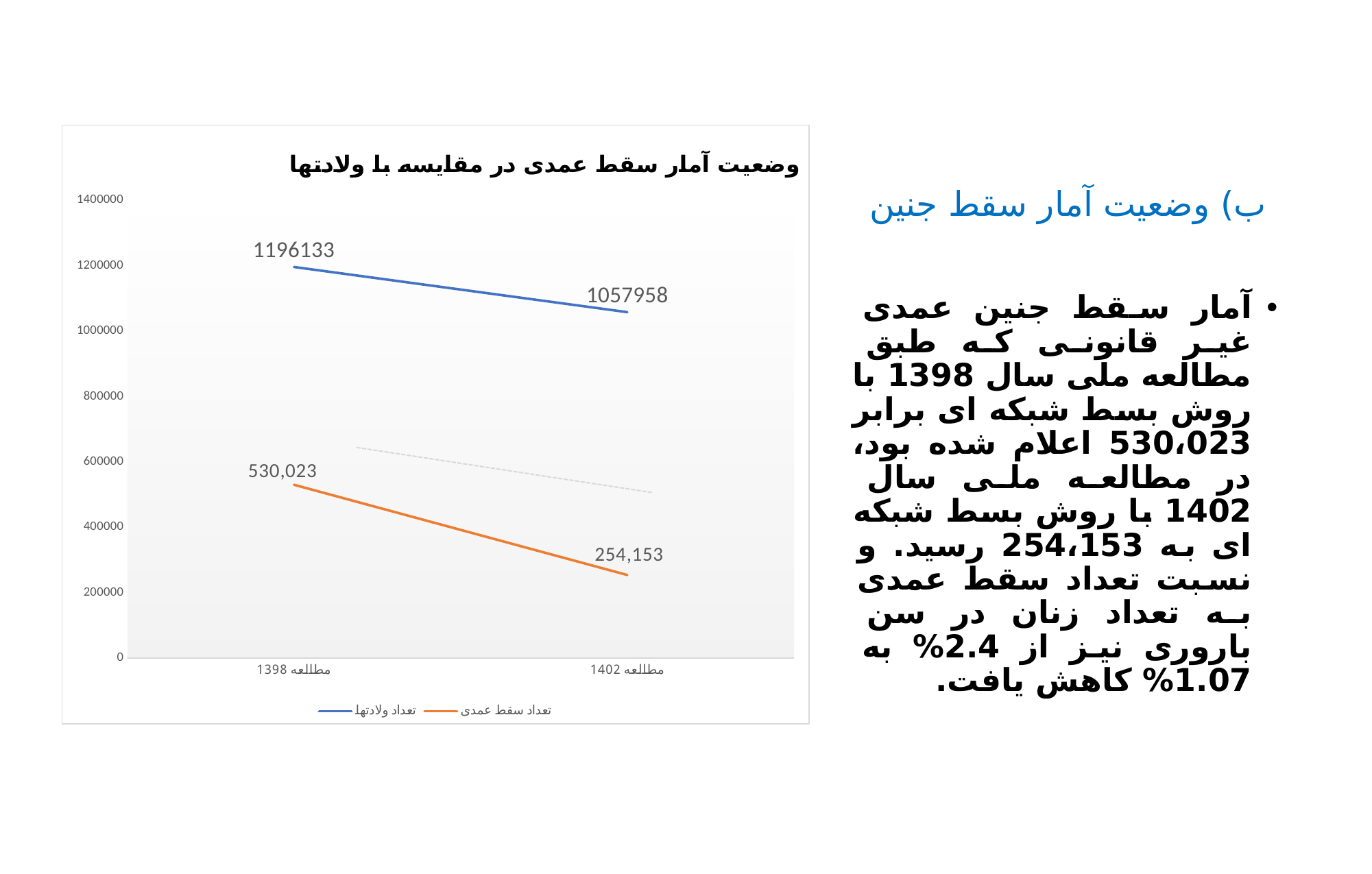
What is the value of تعداد ولادتها for مطالعه 1402? 1057958 How many series does the legend list? 2 What is the value of تعداد سقط عمدی for مطالعه 1398? 530,023 Which series has the higher value for مطالعه 1402, تعداد ولادتها or تعداد سقط عمدی? تعداد ولادتها What is the value of تعداد سقط عمدی for مطالعه 1402? 254,153 How many categories are shown on the x axis? 2 What is the difference between تعداد سقط عمدی in مطالعه 1398 and مطالعه 1402? 275,870 Does تعداد سقط عمدی rise or fall from مطالعه 1398 to مطالعه 1402? fall What is the title of the chart? وضعیت آمار سقط عمدی در مقایسه با ولادتها What is the difference between تعداد ولادتها in مطالعه 1398 and مطالعه 1402? 138175 What is the value of تعداد ولادتها for مطالعه 1398? 1196133 What type of chart is shown on the slide? line chart